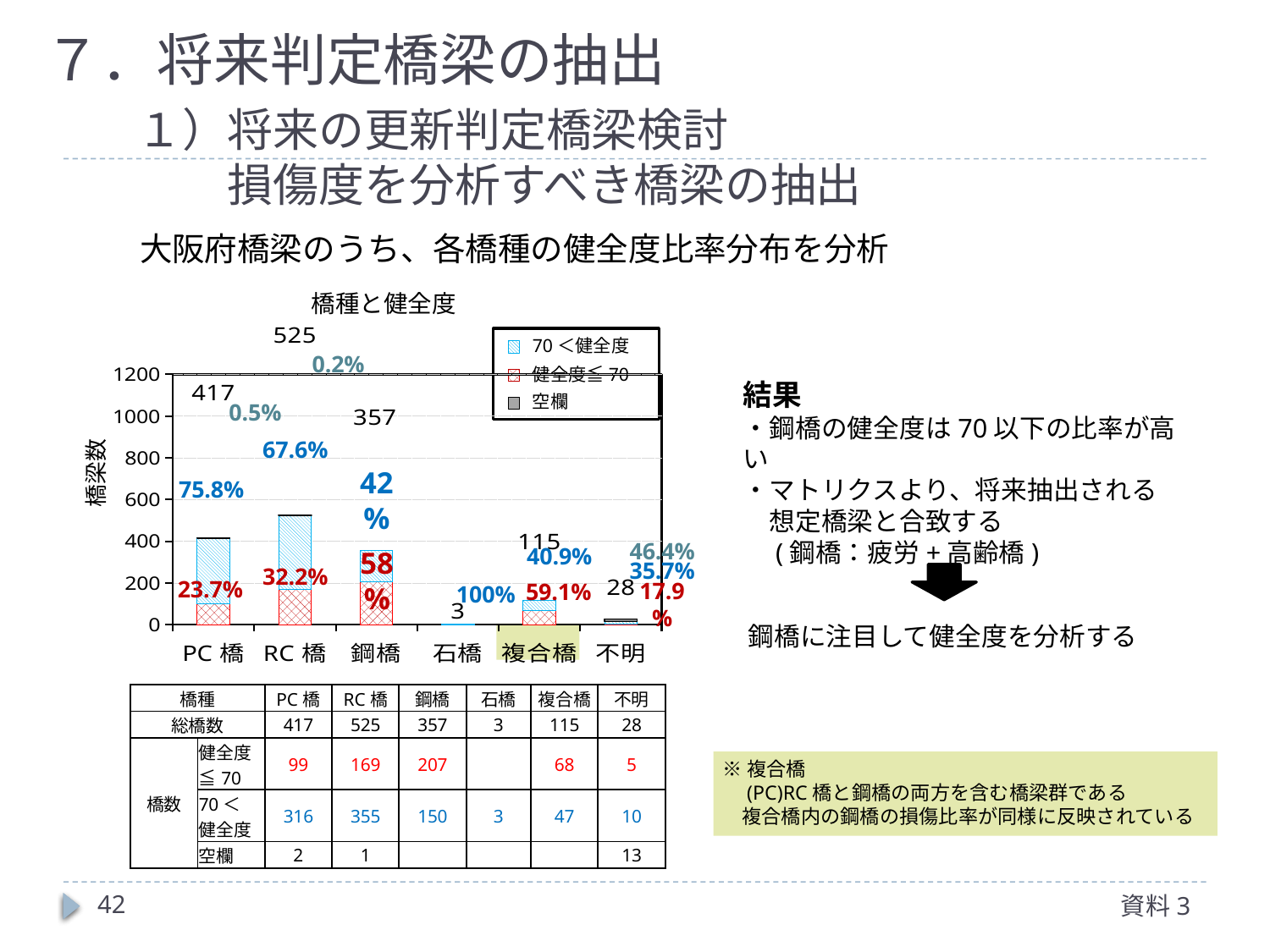
What is the total number of bridges shown for RC橋 in the chart? 525 What is the total number of bridges shown for 複合橋 in the chart? 115 Which has a larger total number of bridges, PC橋 or 鋼橋? PC橋 What is the title of the chart? 橋種と健全度 How many series does the chart legend list? 3 What kind of chart is shown on the slide? bar chart Which bridge type has the lowest total number of bridges in the chart? 石橋 How many bridge type categories are shown on the x axis of the chart? 6 Which bridge type has the highest total number of bridges in the chart? RC橋 What is the total number of bridges shown for 鋼橋 in the chart? 357 What is the difference between the total number of bridges for RC橋 and PC橋? 108 Is the total for 鋼橋 greater or less than 400? less